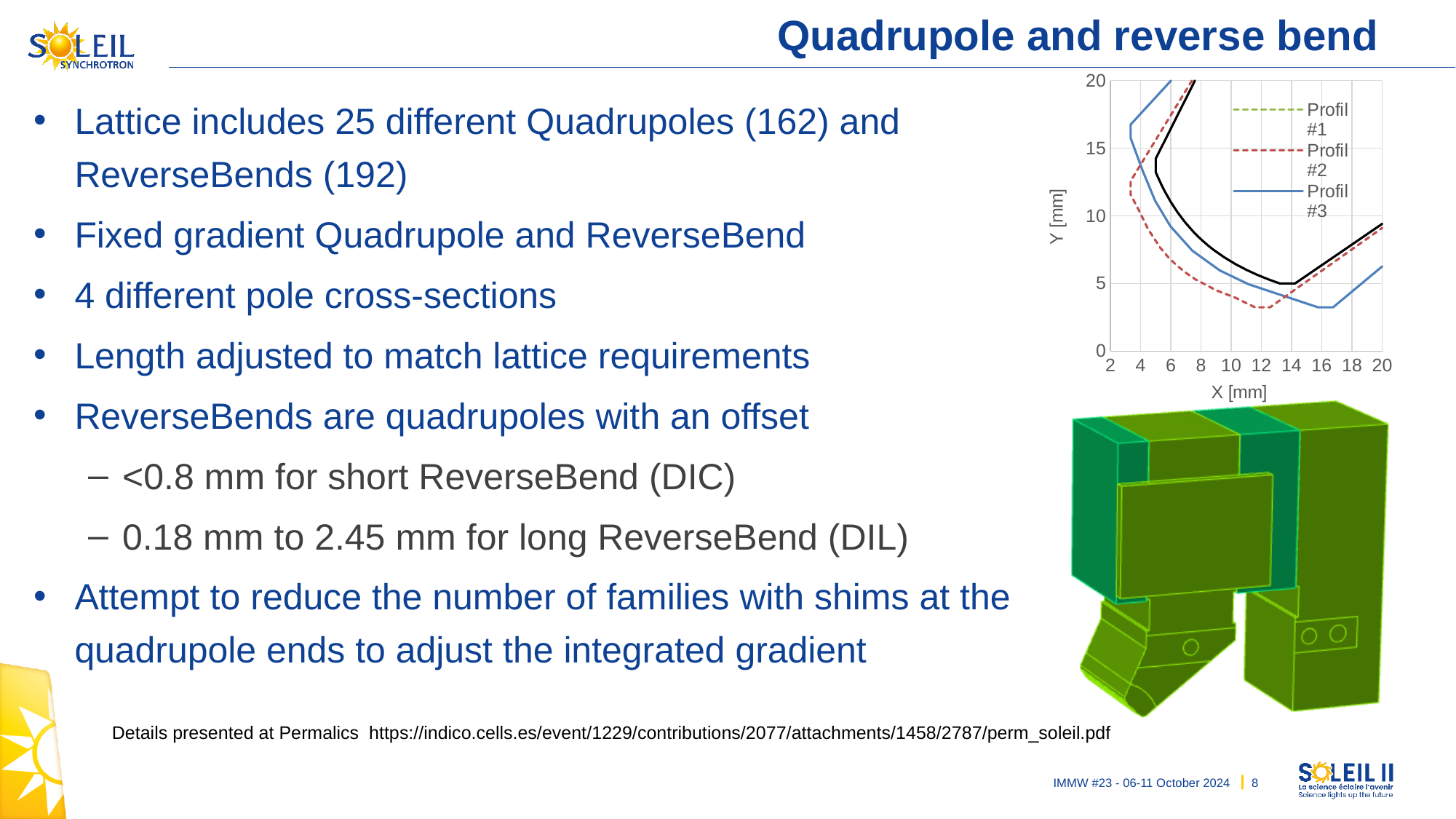
At X = 8, which series has the higher Y value, Profil #2 or Profil #3? Profil #3 Is the Y value of Profil #3 at X = 4 greater or less than 15? greater Is the lowest Y value reached by Profil #2 greater or less than 5? less Is the lowest Y value reached by Profil #3 greater or less than 5? less What kind of chart is shown on the slide? line chart At X = 20, which series has the higher Y value, Profil #2 or Profil #3? Profil #2 What are the names of the series listed in the chart legend? Profil #1, Profil #2, Profil #3 Does Profil #2 rise or fall as X increases from 4 to 12? fall What is the label of the chart's horizontal axis? X [mm] How many series does the chart legend list? 3 Does Profil #3 rise or fall as X increases from 16 to 20? rise